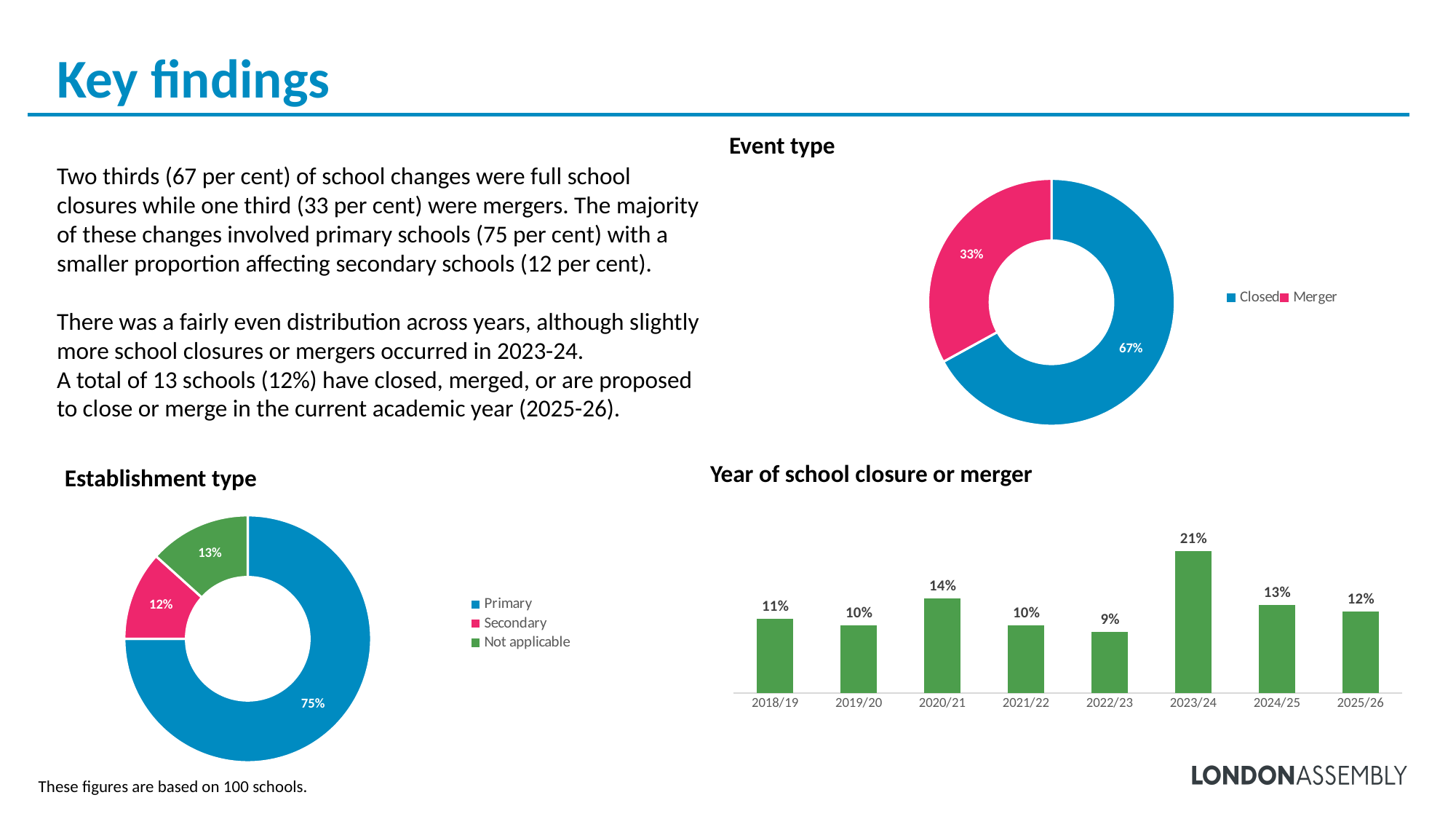
In the 'Event type' chart, what share of school changes were closures? 67% In the 'Year of school closure or merger' chart, what is the value for 2020/21? 14% In the 'Establishment type' chart, which category has the largest share? Primary In the 'Establishment type' chart, what percentage is shown for Secondary? 12% In the 'Establishment type' chart, what colour is the Not applicable slice? Green In the 'Event type' chart, what share of school changes were mergers? 33% In the 'Year of school closure or merger' chart, which year has the lowest value? 2022/23 In the 'Event type' chart, how many categories does the legend list? 2 In the 'Establishment type' chart, what is the difference between the Primary and Not applicable shares? 62% In the 'Year of school closure or merger' chart, how many years are shown on the x axis? 8 In the 'Year of school closure or merger' chart, what kind of chart is shown? Bar chart In the 'Year of school closure or merger' chart, which year has the highest value? 2023/24